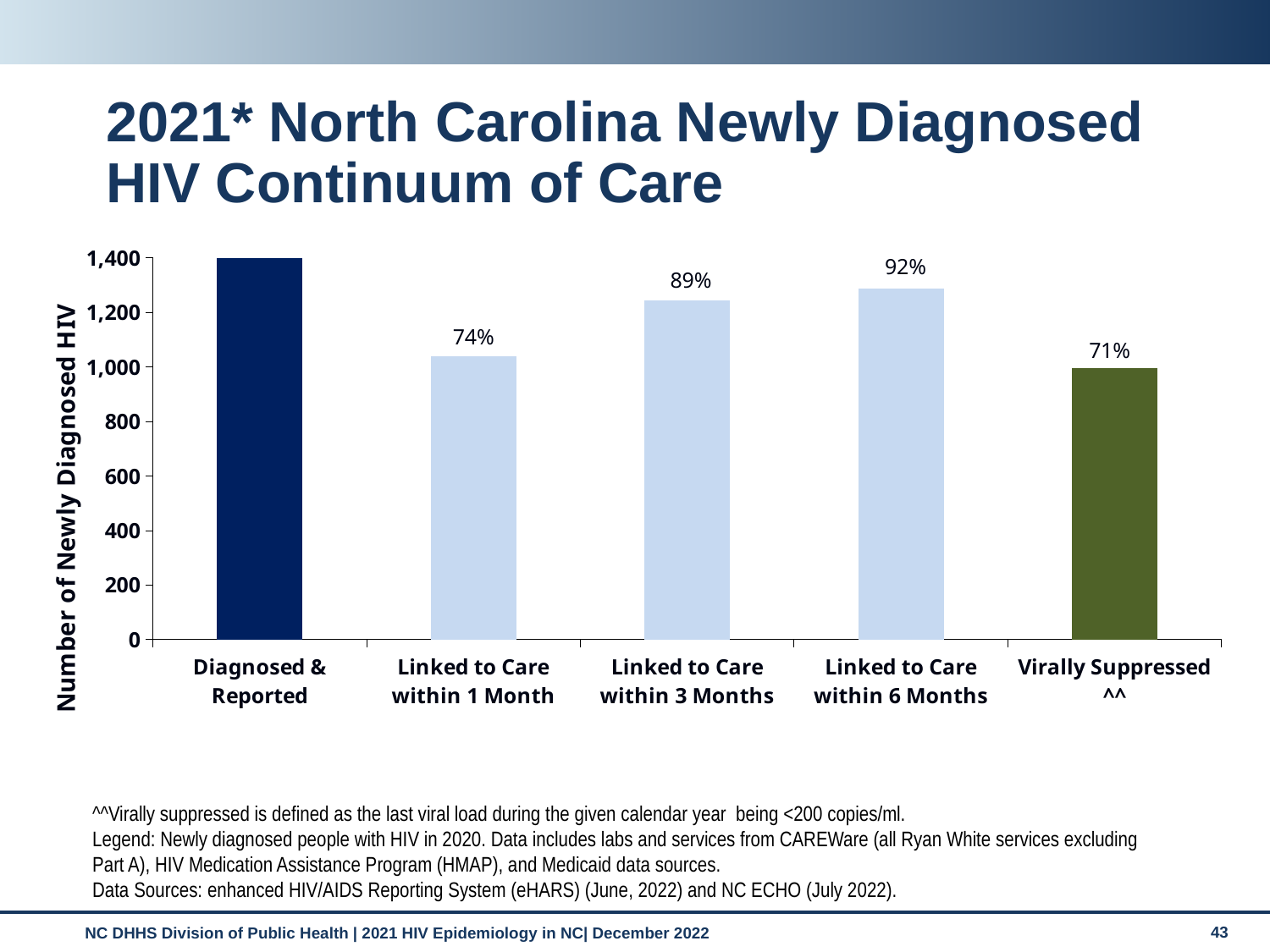
What percentage label is shown above the 'Linked to Care within 3 Months' bar? 89% Which category has the tallest bar in the chart? Diagnosed & Reported What kind of chart is shown on the slide? bar chart What is the difference in percentage points between the labels for 'Linked to Care within 6 Months' and 'Linked to Care within 1 Month'? 18 Which category has the shortest bar in the chart? Virally Suppressed ^^ What percentage label is shown above the 'Virally Suppressed ^^' bar? 71% What percentage label is shown above the 'Linked to Care within 1 Month' bar? 74% Is the value for 'Diagnosed & Reported' greater or less than 1,200? greater How many categories are shown on the x axis of the chart? 5 What percentage label is shown above the 'Linked to Care within 6 Months' bar? 92% What is the title of the y axis of the chart? Number of Newly Diagnosed HIV Which bar is taller: 'Linked to Care within 3 Months' or 'Linked to Care within 1 Month'? Linked to Care within 3 Months